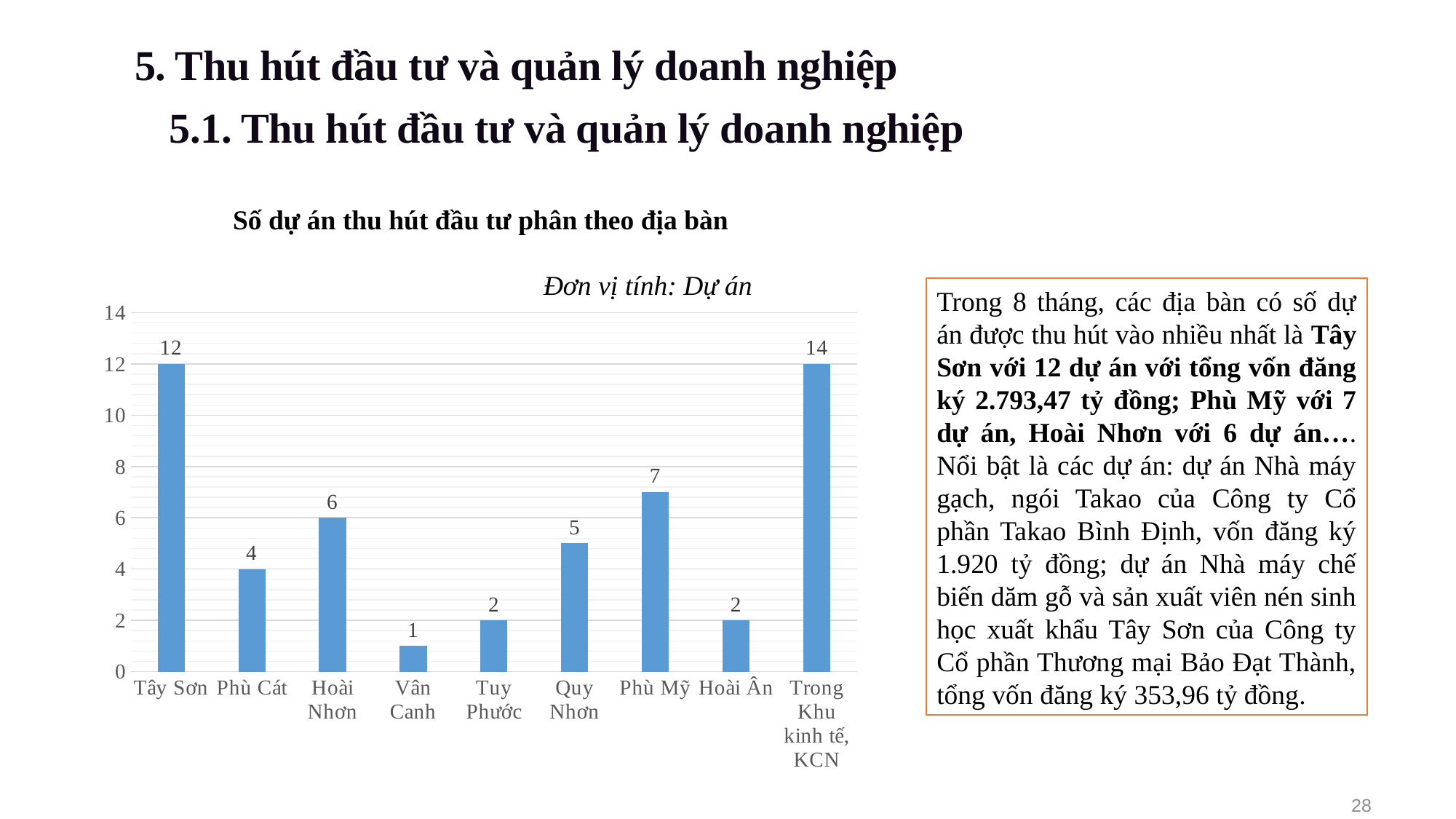
Is the value for Phù Mỹ greater or less than 6? greater What is the title of the chart? Số dự án thu hút đầu tư phân theo địa bàn What is the value for Phù Mỹ? 7 Which is larger, the value for Phù Cát or the value for Quy Nhơn? Quy Nhơn Which category has the lowest value? Vân Canh What is the value for Quy Nhơn? 5 What kind of chart is shown on the slide? bar chart What is the value for Tây Sơn? 12 What is the value for Hoài Nhơn? 6 How many categories are shown on the x axis? 9 What is the difference between the values for Tây Sơn and Phù Mỹ? 5 What is the difference between the values for Hoài Nhơn and Phù Cát? 2